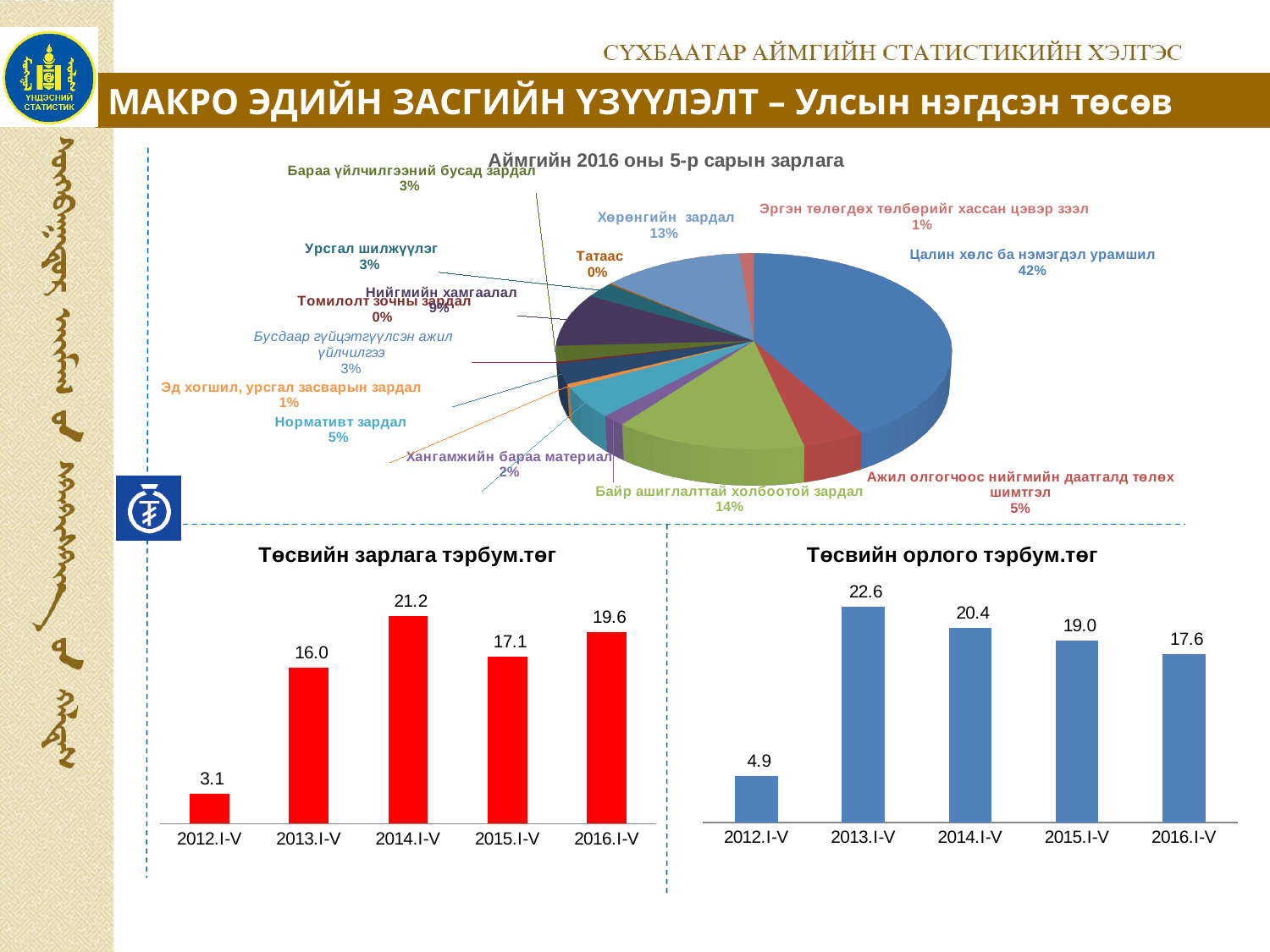
In the bar chart 'Төсвийн зарлага тэрбум.төг', how many periods are shown? 5 In the pie chart 'Аймгийн 2016 оны 5-р сарын зарлага', what share does 'Хөрөнгийн зардал' have? 13% In the pie chart 'Аймгийн 2016 оны 5-р сарын зарлага', what share does 'Байр ашиглалттай холбоотой зардал' have? 14% In the bar chart 'Төсвийн зарлага тэрбум.төг', what is the value for 2014.I-V? 21.2 In the pie chart 'Аймгийн 2016 оны 5-р сарын зарлага', what share does 'Цалин хөлс ба нэмэгдэл урамшил' have? 42% What type of chart is 'Төсвийн орлого тэрбум.төг'? bar chart In the bar chart 'Төсвийн орлого тэрбум.төг', which period has the highest value? 2013.I-V In the bar chart 'Төсвийн орлого тэрбум.төг', do the values rise or fall from 2013.I-V to 2016.I-V? fall In the pie chart 'Аймгийн 2016 оны 5-р сарын зарлага', which category has the largest share? Цалин хөлс ба нэмэгдэл урамшил In the bar chart 'Төсвийн зарлага тэрбум.төг', which period has the lowest value? 2012.I-V In the bar chart 'Төсвийн орлого тэрбум.төг', what is the value for 2013.I-V? 22.6 In the bar chart 'Төсвийн зарлага тэрбум.төг', what is the difference between 2014.I-V and 2015.I-V? 4.1